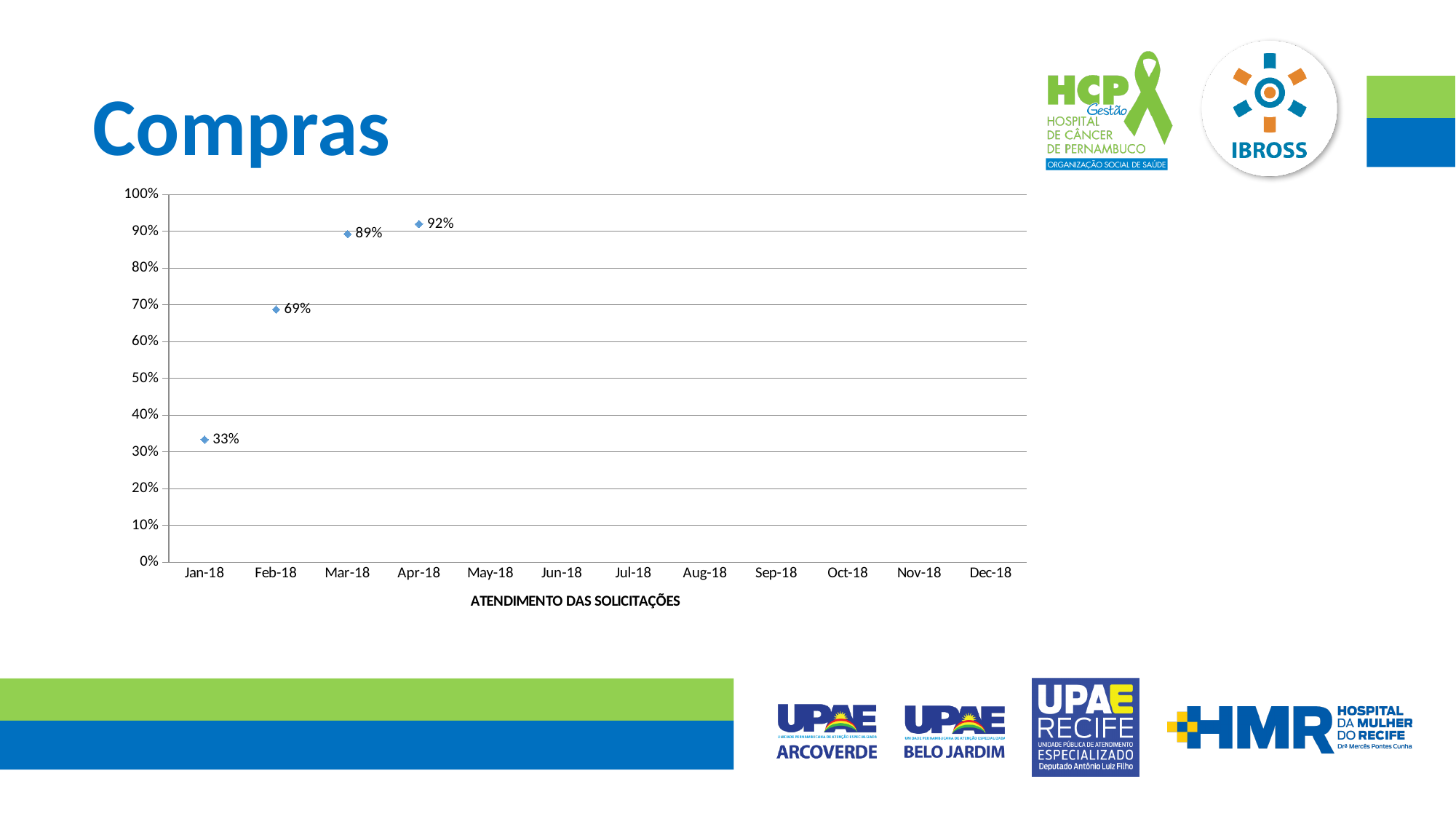
What is the value for Apr-18? 92% What is the value for Feb-18? 69% What is the value for Jan-18? 33% How many months have a plotted data point? 4 What is the label shown below the x axis of the chart? ATENDIMENTO DAS SOLICITAÇÕES Which is larger, the value for Feb-18 or the value for Mar-18? Mar-18 Do the plotted values rise or fall from Jan-18 to Apr-18? rise What is the value for Mar-18? 89% What is the difference between the values for Feb-18 and Jan-18? 36% Which month has the lowest plotted value? Jan-18 Which month has the highest plotted value? Apr-18 What is the difference between the values for Apr-18 and Jan-18? 59%